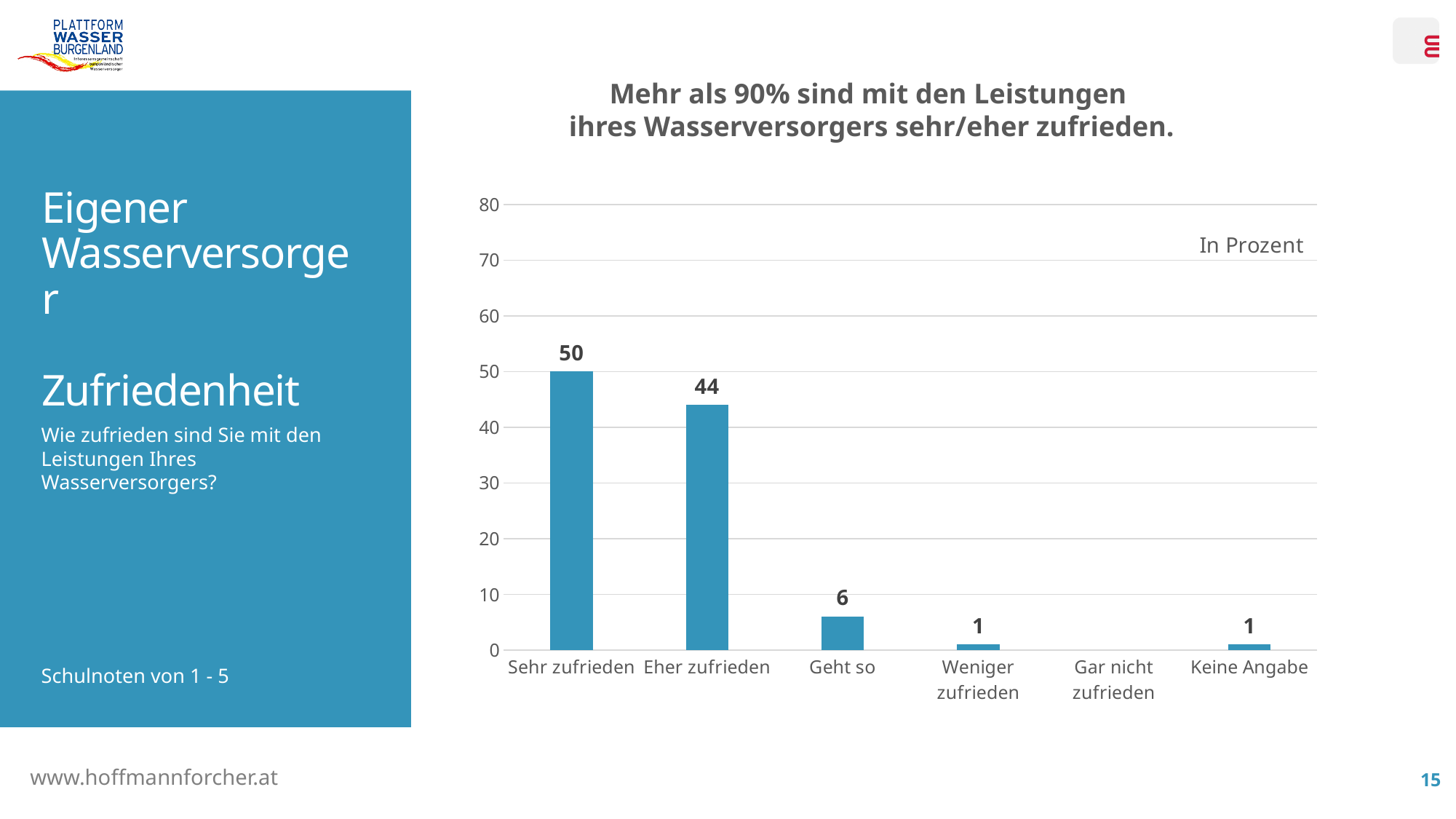
What unit does the chart state its values are in? In Prozent Is the value for "Eher zufrieden" greater or less than 40? greater Which is larger, the value for "Eher zufrieden" or the value for "Geht so"? Eher zufrieden What kind of chart is shown on the slide? bar chart What is the value for "Geht so"? 6 What is the value for "Sehr zufrieden"? 50 Which category has the highest value? Sehr zufrieden How many categories are shown on the x axis? 6 Do the values rise or fall from "Sehr zufrieden" to "Geht so"? fall What is the value for "Keine Angabe"? 1 What is the value for "Eher zufrieden"? 44 What is the difference between the values for "Sehr zufrieden" and "Eher zufrieden"? 6